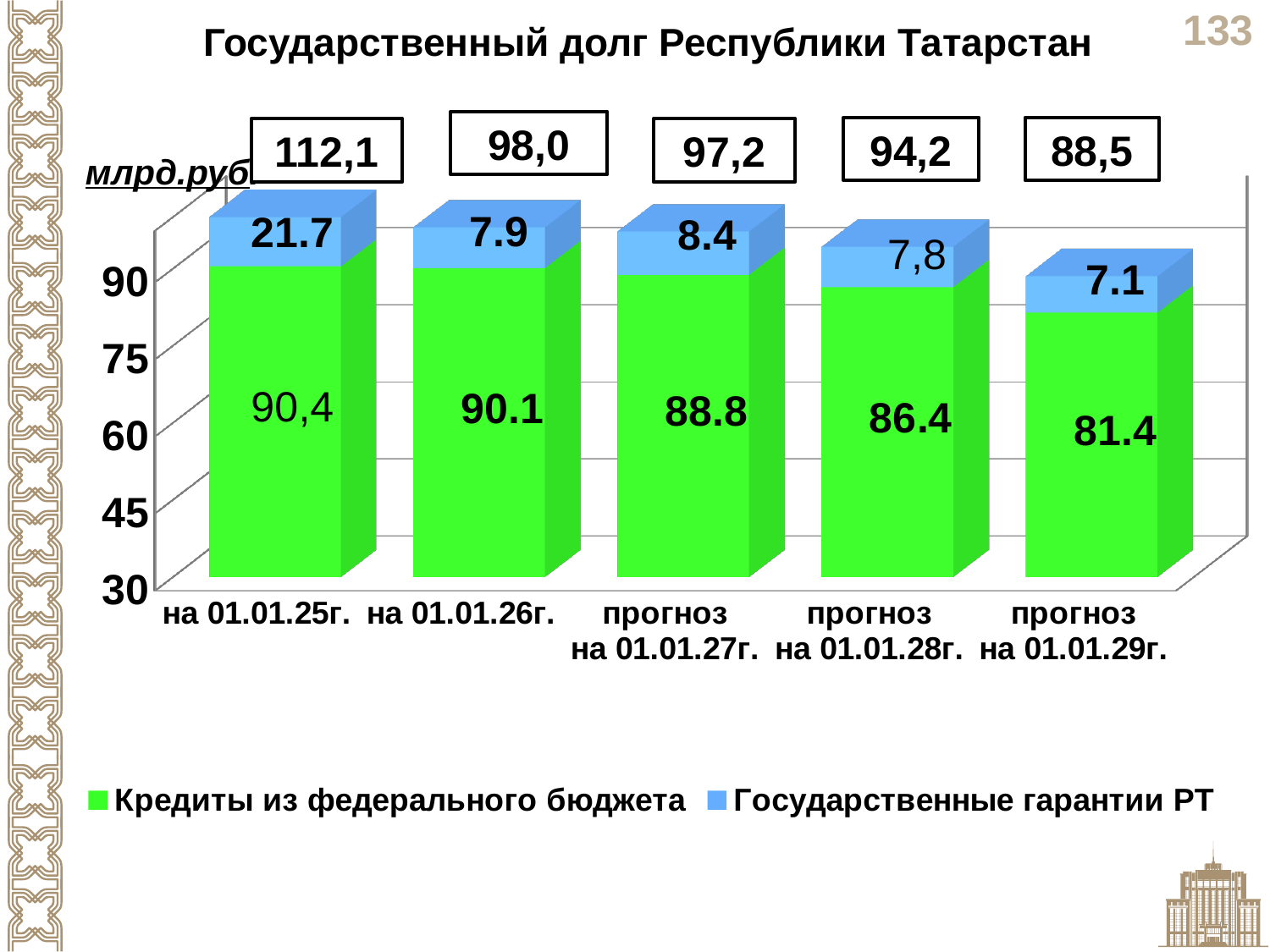
What type of chart is shown on the slide? bar chart What is the value of Государственные гарантии РТ for на 01.01.26г.? 7.9 What is the value of Кредиты из федерального бюджета for прогноз на 01.01.29г.? 81.4 Which is larger: Кредиты из федерального бюджета for прогноз на 01.01.27г. or for прогноз на 01.01.28г.? прогноз на 01.01.27г. What is the value of Кредиты из федерального бюджета for на 01.01.25г.? 90,4 What is the total state debt shown above the bar for на 01.01.25г.? 112,1 What is the difference between the Государственные гарантии РТ values for на 01.01.25г. and на 01.01.26г.? 13.8 How many categories are shown on the x axis? 5 What is the total state debt shown above the bar for прогноз на 01.01.27г.? 97,2 Which category has the highest value for Государственные гарантии РТ? на 01.01.25г. How many series does the legend list? 2 Which category has the lowest value for Кредиты из федерального бюджета? прогноз на 01.01.29г.